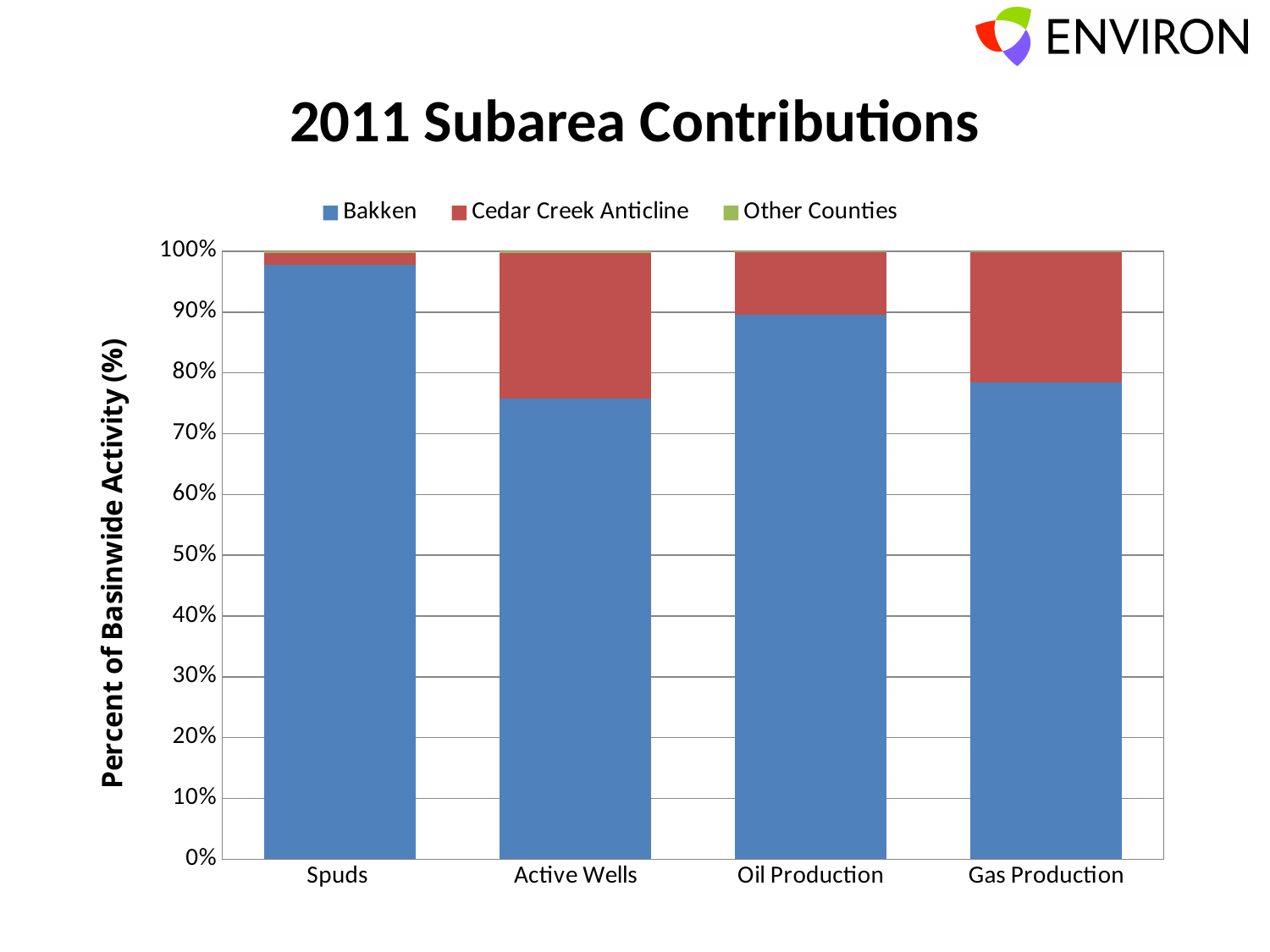
Is the Bakken share for Gas Production greater or less than 70%? greater What kind of chart is shown on the slide? Stacked bar chart How many series does the legend list? 3 Is the Bakken share for Active Wells greater or less than 80%? less Is the Bakken share for Spuds greater or less than 90%? greater What is the title of the chart? 2011 Subarea Contributions Which category has the lowest Bakken share? Active Wells Which category has the largest Cedar Creek Anticline share? Active Wells What is the label on the y axis? Percent of Basinwide Activity (%) Which has the larger Bakken share, Oil Production or Gas Production? Oil Production How many categories are shown along the x axis? 4 Which category has the highest Bakken share? Spuds